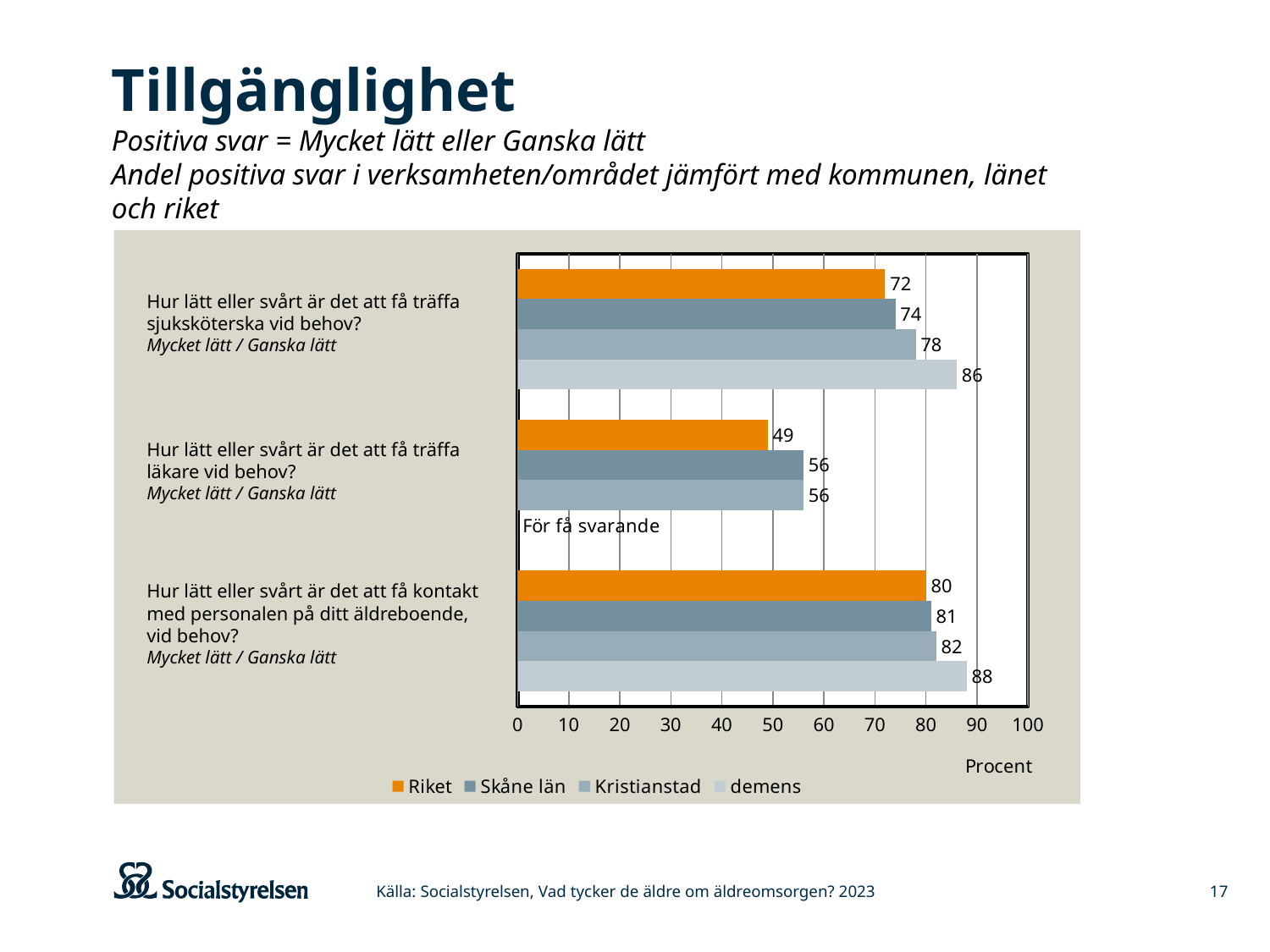
What is the difference between the demens value and the Riket value on the question about meeting a nurse (sjuksköterska)? 14 What is the value for Kristianstad on the question about getting in contact with staff at the care home? 82 Which series has the lowest value on the question about meeting a doctor (läkare) when needed? Riket What is the value for Riket on the question about meeting a nurse (sjuksköterska) when needed? 72 What is the value for demens on the question about meeting a nurse (sjuksköterska) when needed? 86 What is the value for Riket on the question about meeting a doctor (läkare) when needed? 49 What is shown instead of a bar for demens on the question about meeting a doctor (läkare)? För få svarande What is the label on the horizontal axis? Procent How many series does the legend list? 4 Which series has the highest value on the question about getting in contact with staff at the care home? demens Which is larger on the question about meeting a doctor (läkare): the value for Skåne län or the value for Riket? Skåne län What kind of chart is shown on the slide? Bar chart